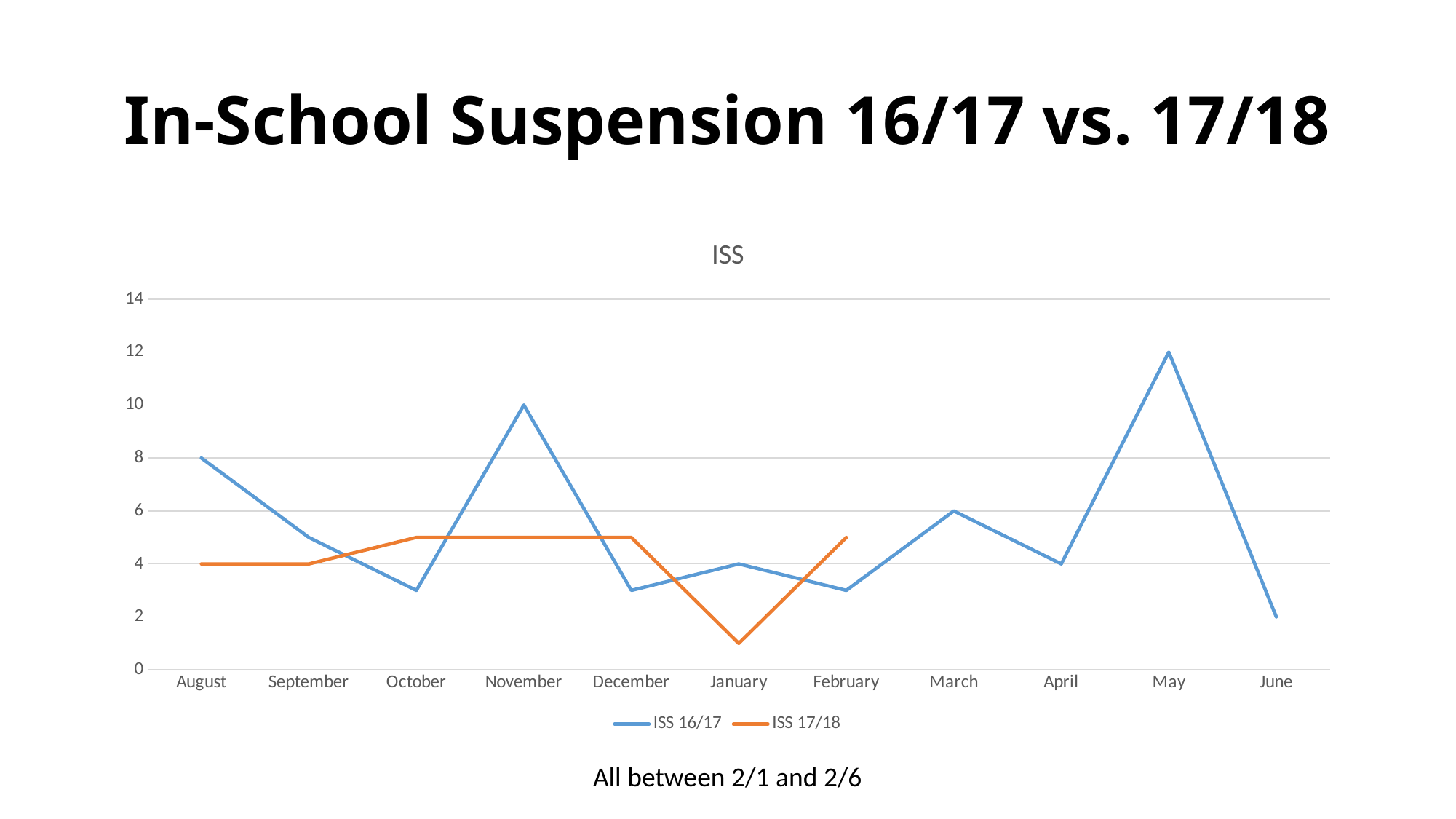
Is the value for ISS 17/18 in December greater or less than 4? greater What is the value for ISS 16/17 in August? 8 What is the value for ISS 16/17 in November? 10 What is the difference between the ISS 16/17 values for May and June? 10 What is the value for ISS 16/17 in May? 12 How many series does the legend list? 2 How many months are shown on the x axis? 11 What is the value for ISS 17/18 in August? 4 In which month is the ISS 16/17 value highest? May Which series has the larger value in November, ISS 16/17 or ISS 17/18? ISS 16/17 In which month is the ISS 17/18 value lowest? January What kind of chart is shown on the slide? line chart